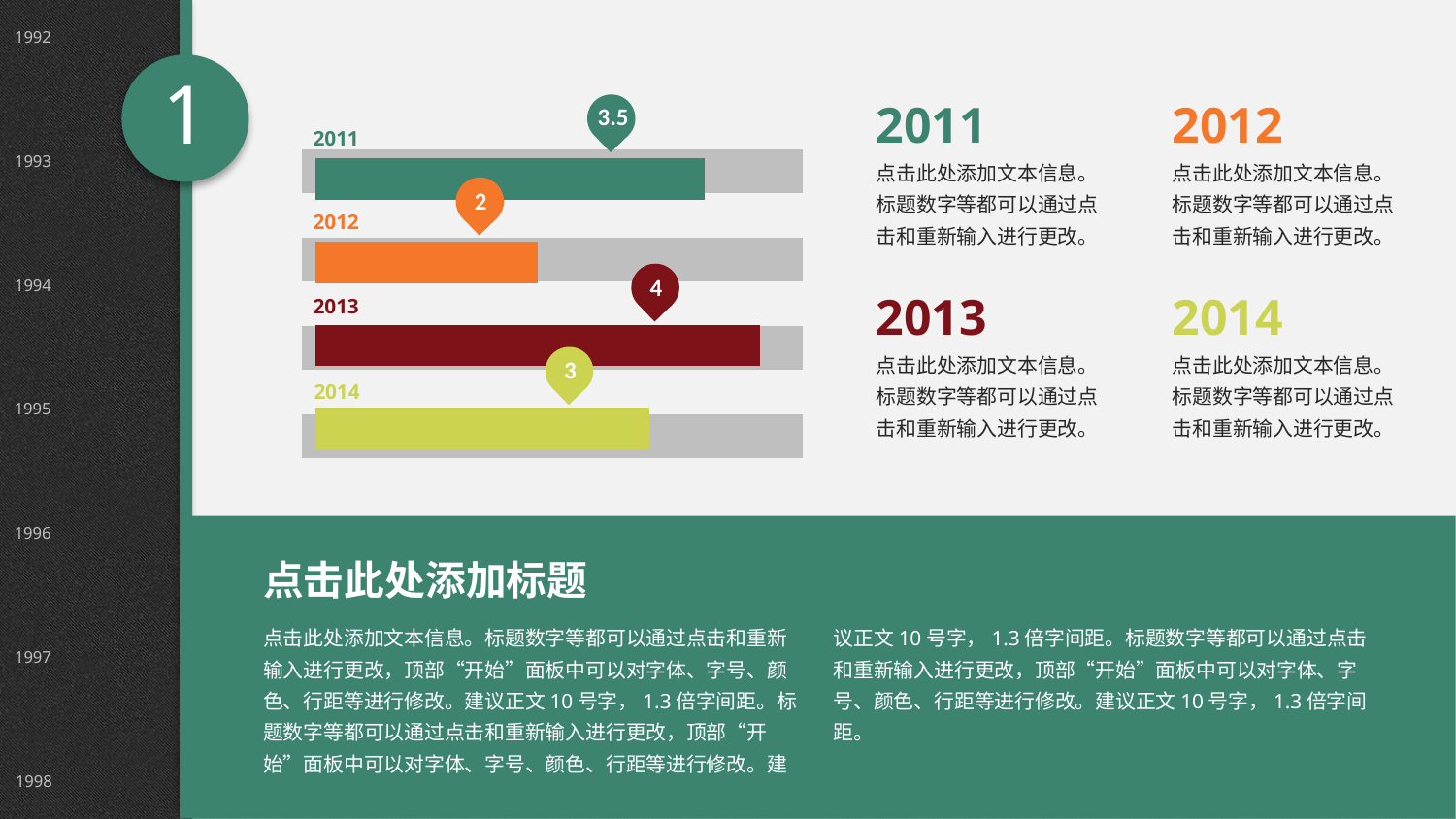
What is the value for 2011? 3.5 Which year has the lowest value? 2012 Which is larger, the value for 2011 or the value for 2014? 2011 What is the value for 2012? 2 What colour is the bar for 2013? dark red How many years are shown in the chart? 4 Which year has the highest value? 2013 What is the value for 2013? 4 What is the value for 2014? 3 What is the difference between the values for 2011 and 2014? 0.5 What is the difference between the values for 2013 and 2012? 2 What kind of chart is shown on the slide? bar chart